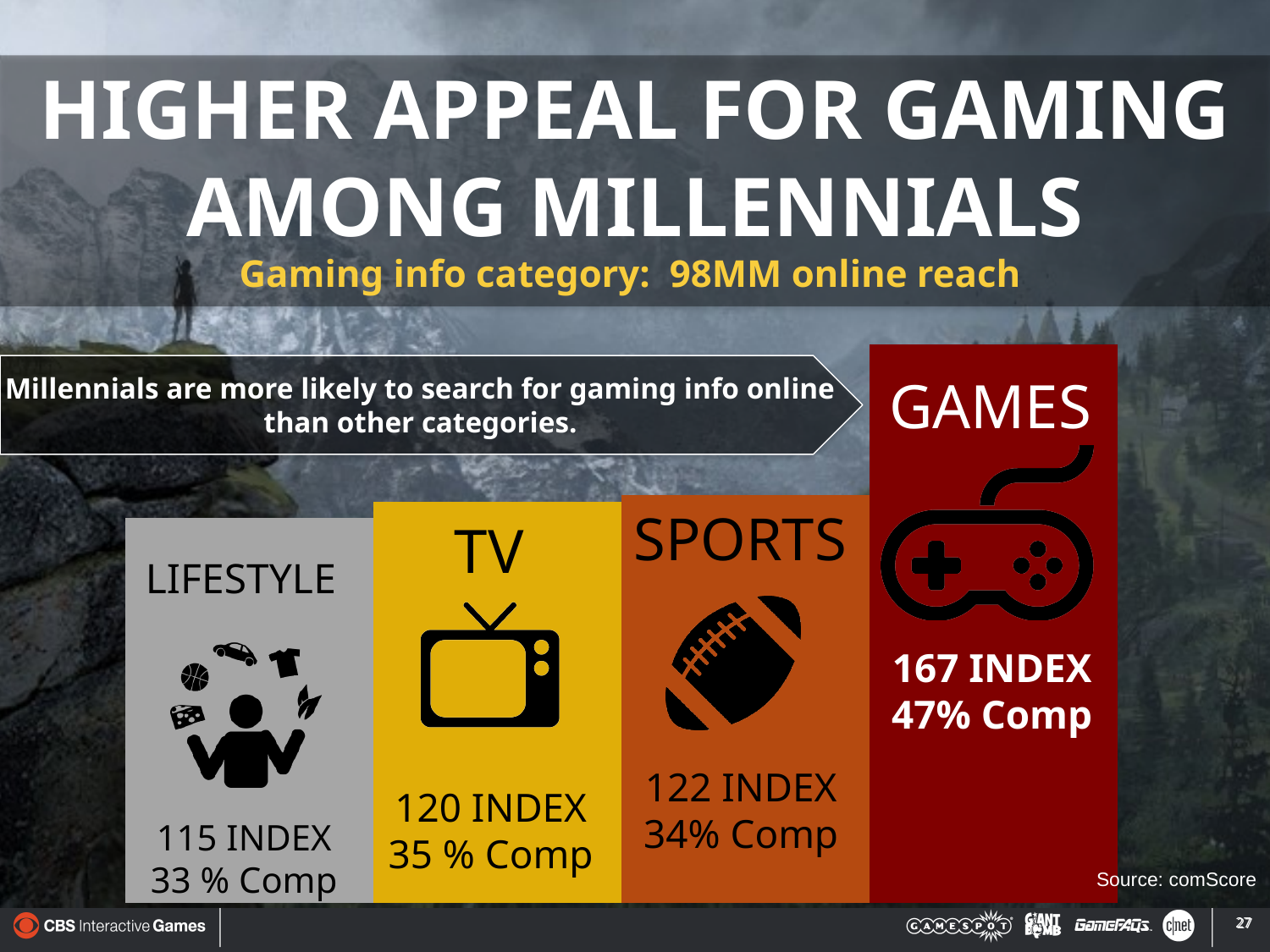
What is the index value for GAMES? 167 INDEX Which category has the highest index? GAMES Which category has the lowest index? LIFESTYLE Which has a higher Comp percentage, TV or SPORTS? TV What kind of chart is shown on the slide? bar chart What is the online reach stated for the gaming info category in the subtitle? 98MM online reach How many categories are shown in the chart? 4 What is the index value for LIFESTYLE? 115 INDEX What is the Comp percentage for SPORTS? 34% Comp What is the Comp percentage for TV? 35 % Comp What is the difference between the GAMES index and the SPORTS index? 45 What is the difference between the TV index and the LIFESTYLE index? 5